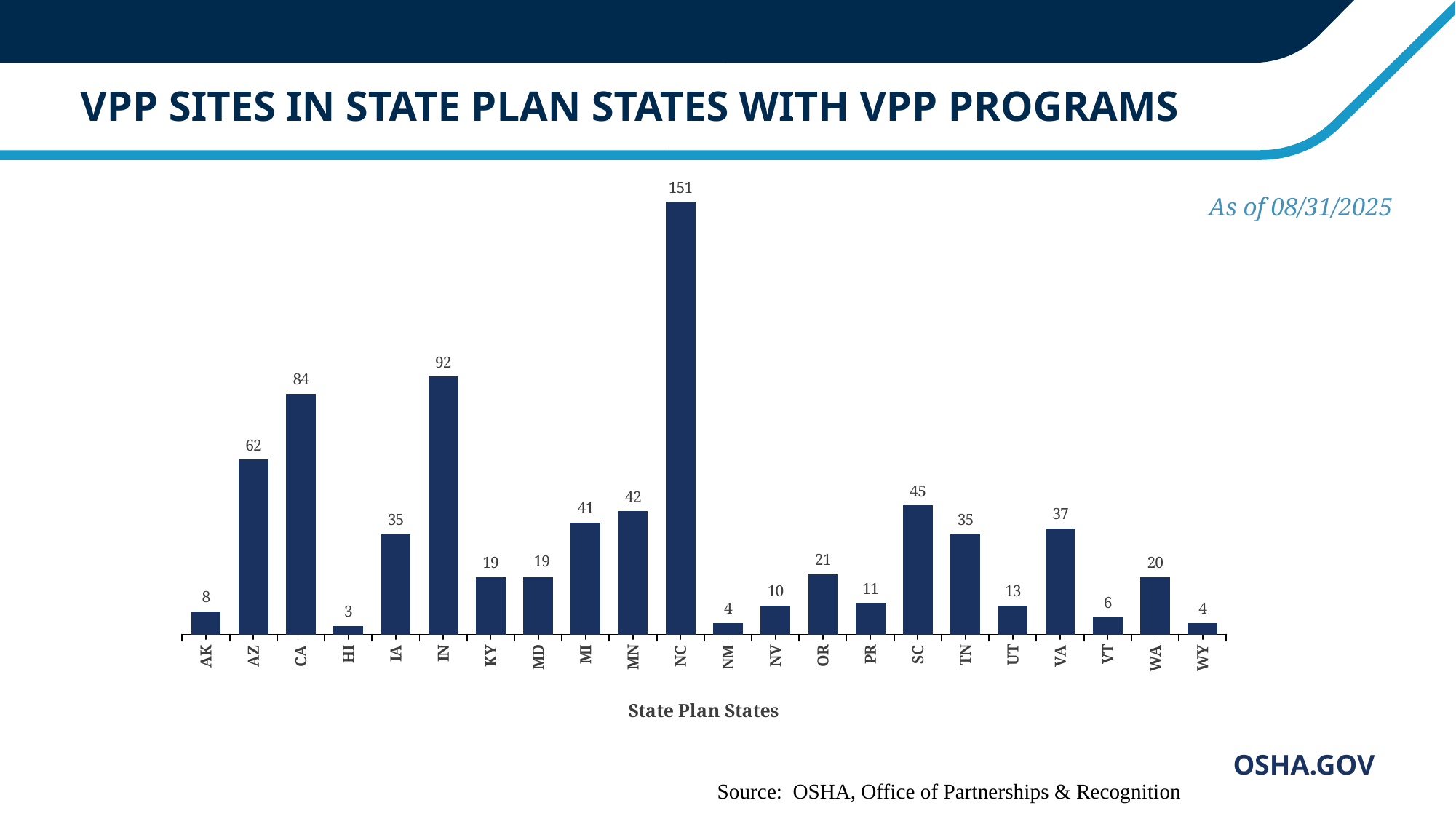
What kind of chart is shown on the slide? Bar chart Which has more VPP sites, MI or MN? MN How many states are shown on the x axis? 22 What is the difference between the values for NC and IN? 59 How many VPP sites does NC have? 151 What is the value shown for WA? 20 What is the value shown for IN? 92 What is the difference between the values for CA and AZ? 22 Which state has the lowest number of VPP sites? HI Which has more VPP sites, SC or TN? SC Which state has the highest number of VPP sites? NC What is the x-axis title of the chart? State Plan States